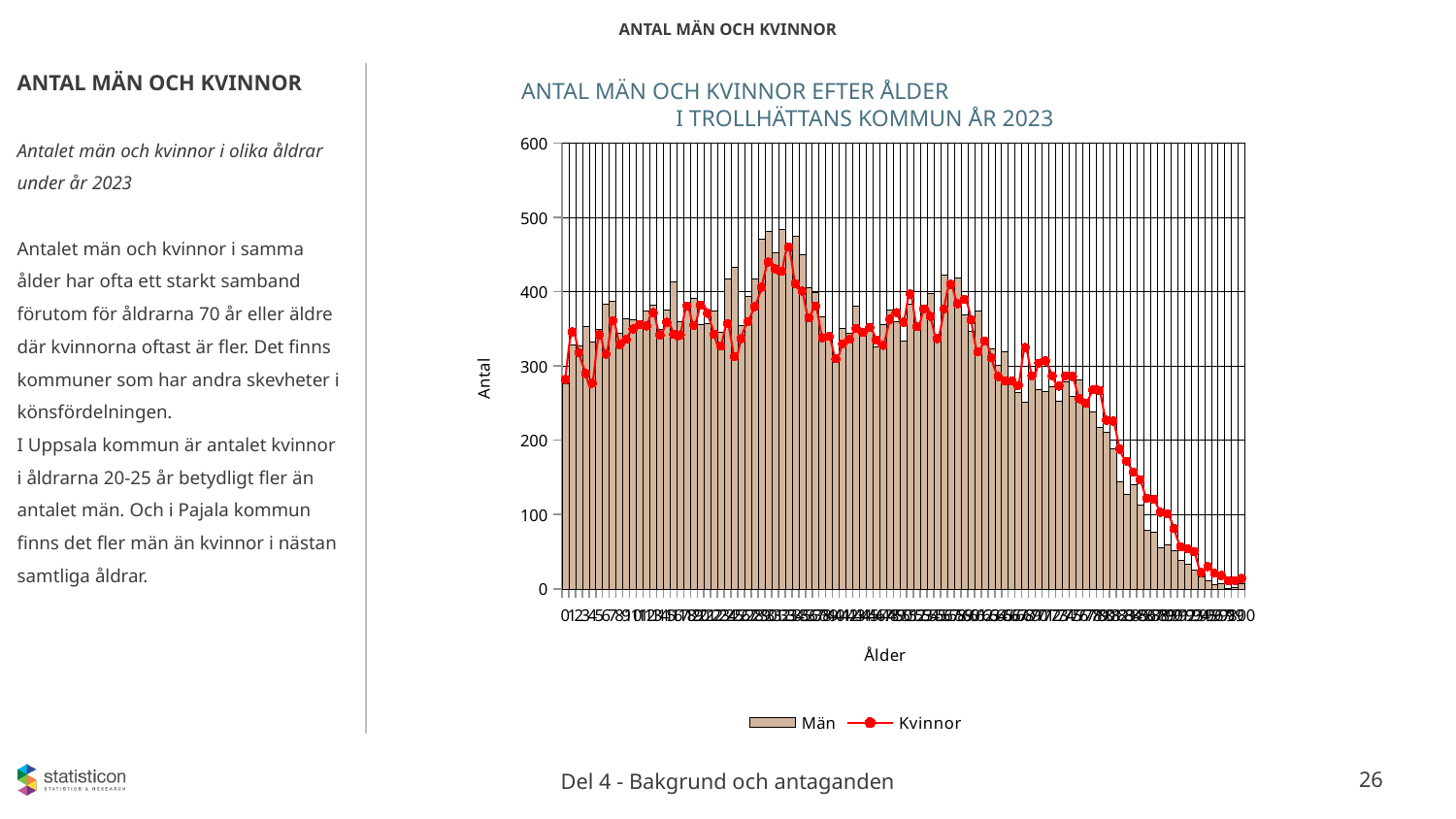
Which series is drawn as bars and which as a line with markers? Män as bars, Kvinnor as a red line with markers Is the value for Män at age 0 greater or less than 200? greater Do the values generally rise or fall as age increases from about 60 to 100? Fall What is the label of the horizontal axis? Ålder What kind of chart is shown on the slide? A combined bar and line chart What is the title of the chart? ANTAL MÄN OCH KVINNOR EFTER ÅLDER I TROLLHÄTTANS KOMMUN ÅR 2023 Is the value for Kvinnor at age 100 greater or less than 100? less Is the highest value for Män greater or less than 500? less What is the highest value shown on the vertical axis? 600 What is the label of the vertical axis? Antal How many series does the legend list? 2 At the oldest ages (around 90 and above), which series has the larger values, Män or Kvinnor? Kvinnor